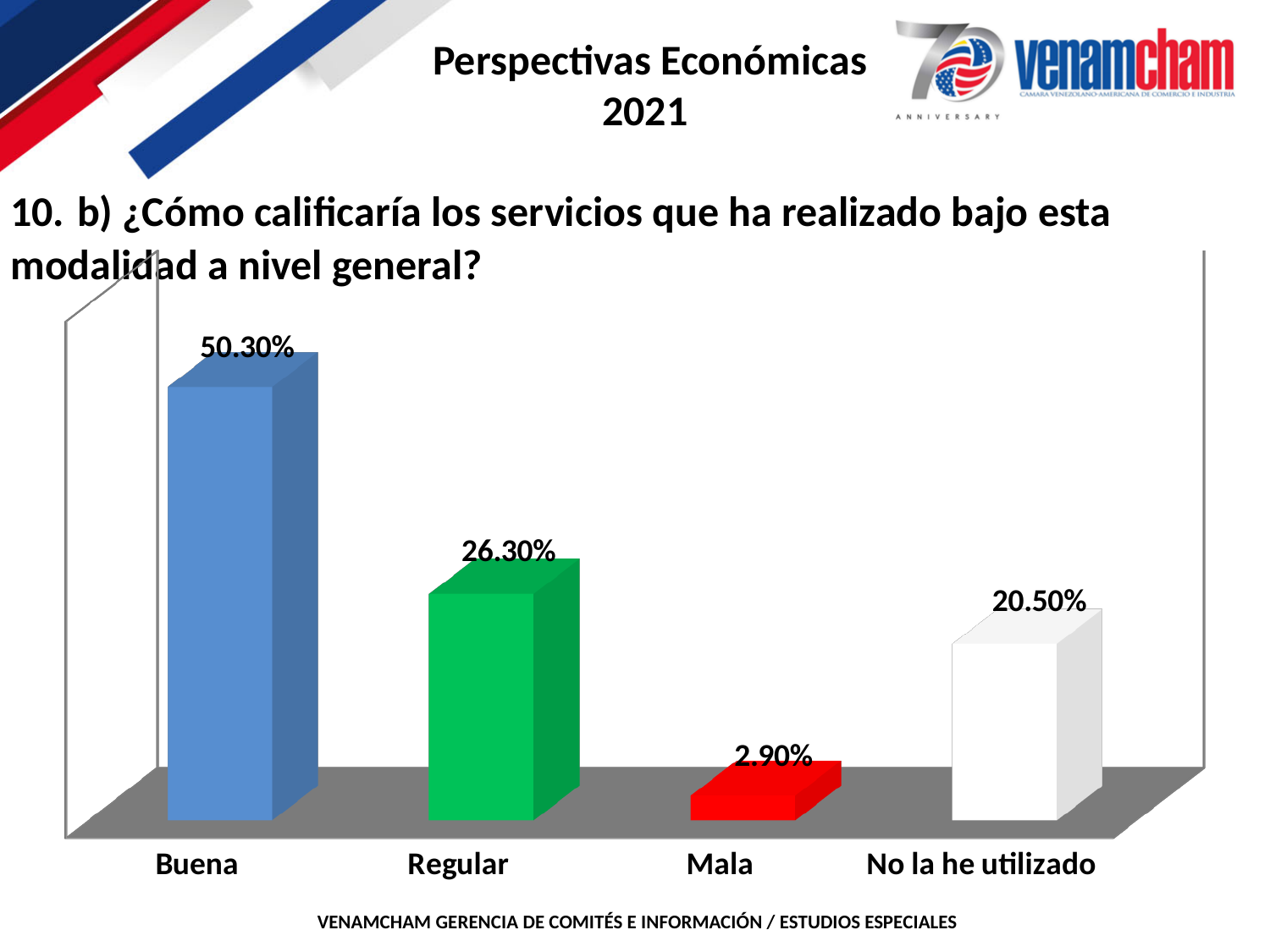
Which category has the highest value? Buena What is the value for Buena? 50.30% Which is larger, the value for Regular or the value for No la he utilizado? Regular How many categories are shown on the chart? 4 What is the value for Regular? 26.30% What kind of chart is shown on the slide? Bar chart Which category has the lowest value? Mala What is the value for No la he utilizado? 20.50% What colour is the bar for Mala? Red What is the difference between the values for Buena and Regular? 24.00% What is the difference between the values for Regular and No la he utilizado? 5.80% What is the value for Mala? 2.90%